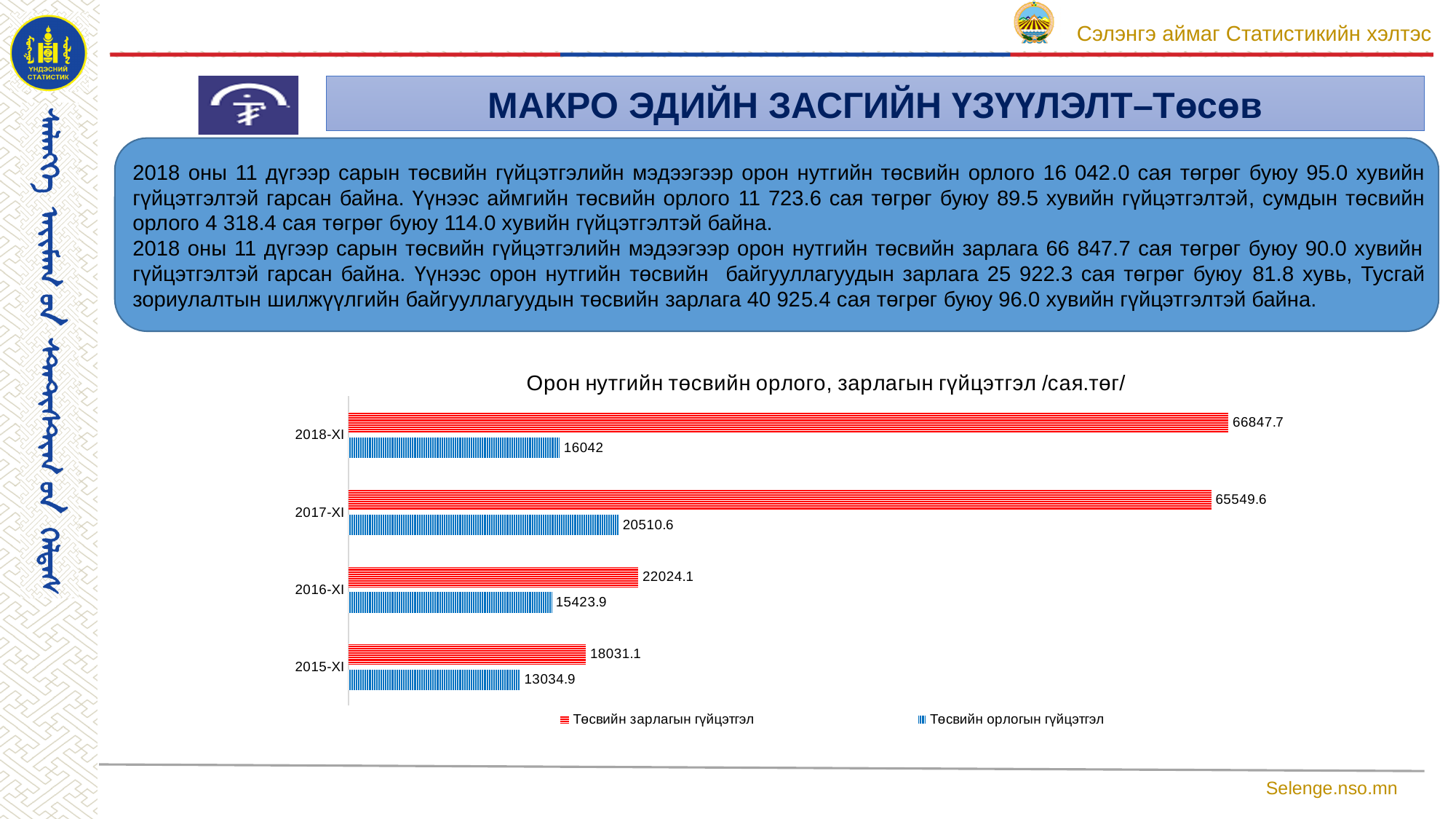
What is the difference between Төсвийн зарлагын гүйцэтгэл and Төсвийн орлогын гүйцэтгэл for 2018-XI? 50805.7 What is the value of Төсвийн зарлагын гүйцэтгэл for 2018-XI? 66847.7 How many periods are shown on the chart? 4 What is the value of Төсвийн орлогын гүйцэтгэл for 2015-XI? 13034.9 What type of chart is shown on the slide? bar chart How many series does the legend list? 2 Which is larger: Төсвийн орлогын гүйцэтгэл for 2018-XI or for 2016-XI? 2018-XI Which period has the highest value of Төсвийн орлогын гүйцэтгэл? 2017-XI What is the value of Төсвийн орлогын гүйцэтгэл for 2017-XI? 20510.6 What is the value of Төсвийн зарлагын гүйцэтгэл for 2016-XI? 22024.1 Which period has the lowest value of Төсвийн зарлагын гүйцэтгэл? 2015-XI What is the difference between Төсвийн орлогын гүйцэтгэл for 2017-XI and 2016-XI? 5086.7